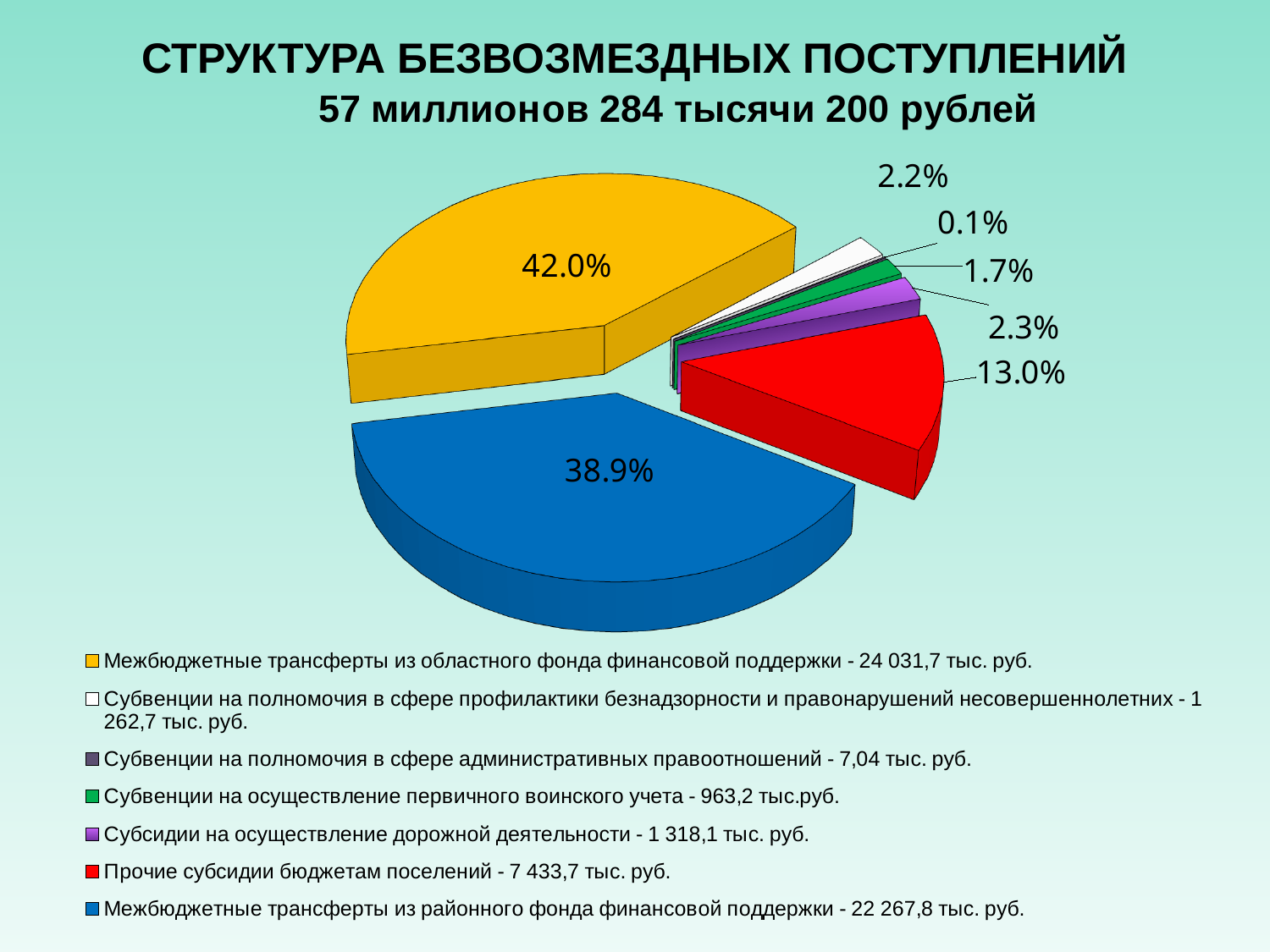
How many slices does the pie chart have? 7 What share of the pie is 'Межбюджетные трансферты из областного фонда финансовой поддержки'? 42.0% What is the difference in percentage points between the 42.0% slice and the 38.9% slice? 3.1 Which category has the smallest share of the pie? Субвенции на полномочия в сфере административных правоотношений Which is larger: the share for 'Прочие субсидии бюджетам поселений' or the share for 'Субвенции на осуществление первичного воинского учета'? Прочие субсидии бюджетам поселений What kind of chart is shown on the slide? pie chart Which category has the largest share of the pie? Межбюджетные трансферты из областного фонда финансовой поддержки What share of the pie is 'Субсидии на осуществление дорожной деятельности'? 2.3% What share of the pie is 'Прочие субсидии бюджетам поселений'? 13.0% What total amount is stated in the chart title? 57 миллионов 284 тысячи 200 рублей How many entries does the legend list? 7